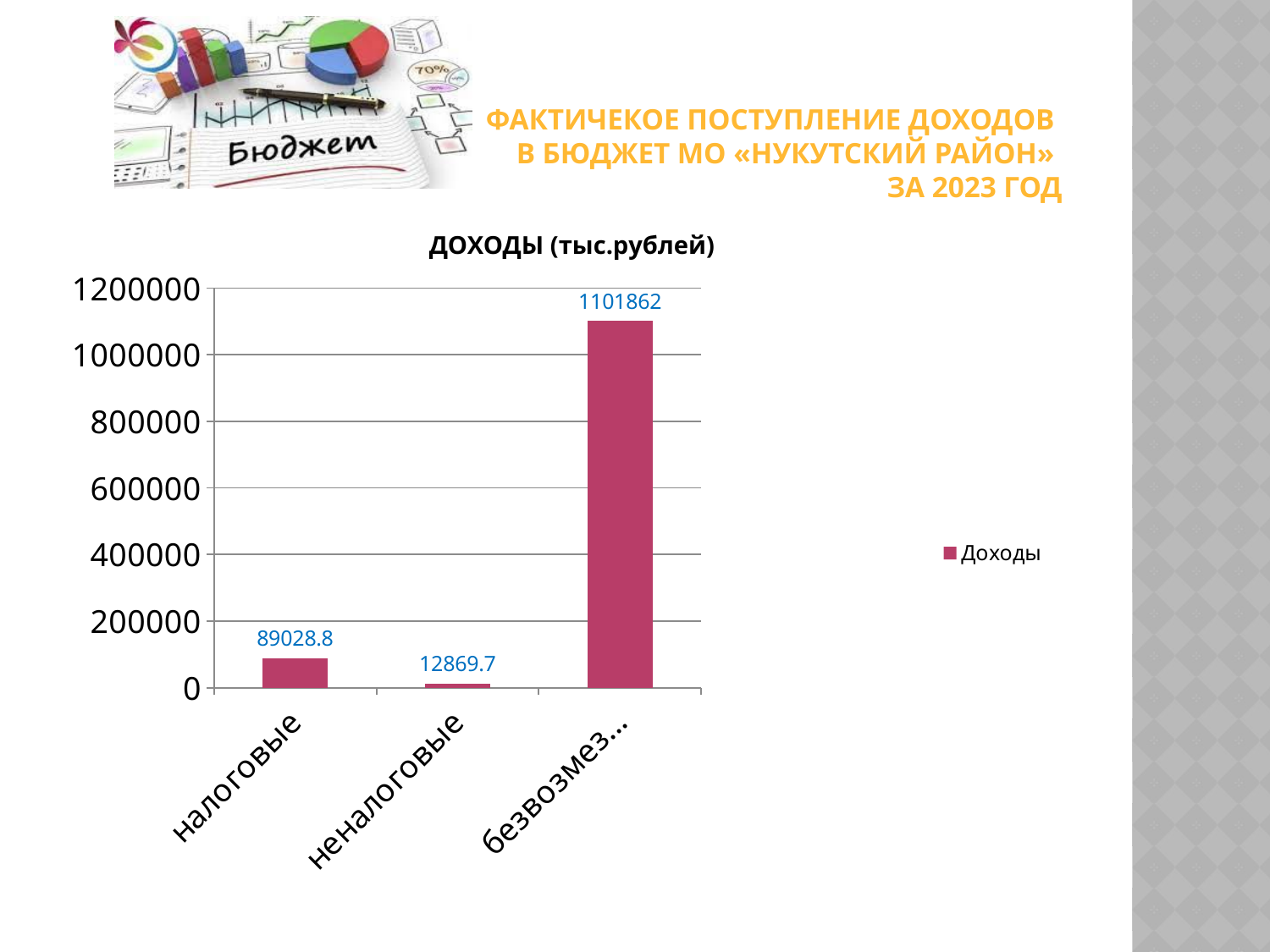
What is the value of the third bar (безвозмез...) in the ДОХОДЫ (тыс.рублей) chart? 1101862 What is the value for налоговые in the ДОХОДЫ (тыс.рублей) chart? 89028.8 What kind of chart is the ДОХОДЫ (тыс.рублей) chart? bar chart Which is larger in the ДОХОДЫ (тыс.рублей) chart: налоговые or неналоговые? налоговые Is the value of the third bar (безвозмез...) in the ДОХОДЫ (тыс.рублей) chart greater or less than 1000000? greater Which category has the lowest value in the ДОХОДЫ (тыс.рублей) chart? неналоговые Which category has the highest value in the ДОХОДЫ (тыс.рублей) chart? безвозмез... (the third category) Is the value for налоговые in the ДОХОДЫ (тыс.рублей) chart greater or less than 200000? less What is the value for неналоговые in the ДОХОДЫ (тыс.рублей) chart? 12869.7 How many series does the legend of the ДОХОДЫ (тыс.рублей) chart list? 1 How many categories are shown in the ДОХОДЫ (тыс.рублей) chart? 3 What is the difference between the values for налоговые and неналоговые in the ДОХОДЫ (тыс.рублей) chart? 76159.1